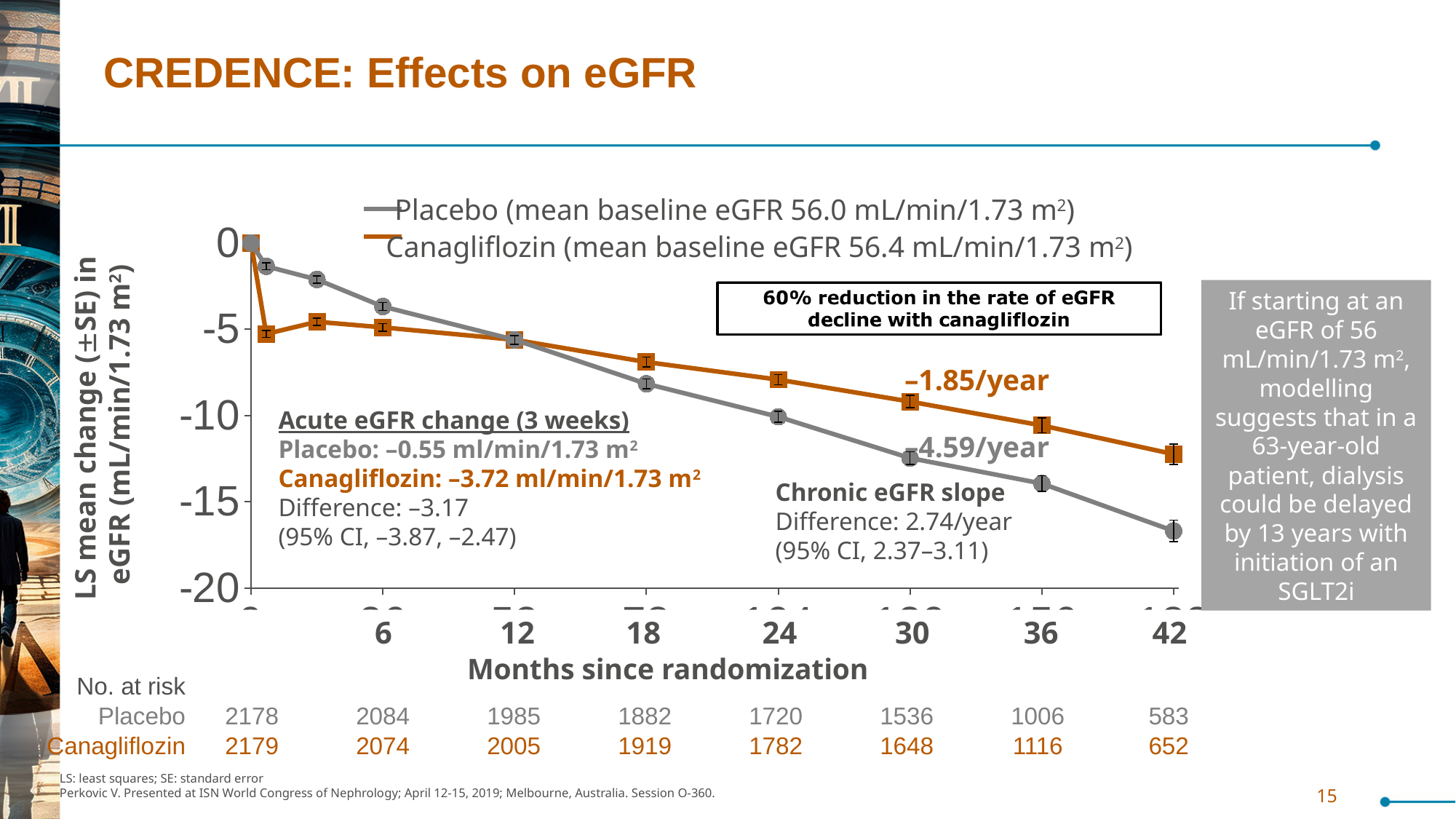
Which colour is used for the Canagliflozin line? orange What is the chronic eGFR slope annotated for Placebo? –4.59/year Is the Canagliflozin value at 42 months greater or less than -15? greater What is the chronic eGFR slope annotated for Canagliflozin? –1.85/year At 42 months, which series has the higher (less negative) eGFR change, Placebo or Canagliflozin? Canagliflozin Is the Placebo value at 30 months greater or less than -10? less Is the Placebo value at 42 months greater or less than -15? less What kind of chart is shown on the slide? line chart What is the acute eGFR change (3 weeks) for Canagliflozin? –3.72 ml/min/1.73 m² Do the eGFR values for Placebo rise or fall as months since randomization increase? fall What is the title of the slide containing the chart? CREDENCE: Effects on eGFR How many series does the chart legend list? 2